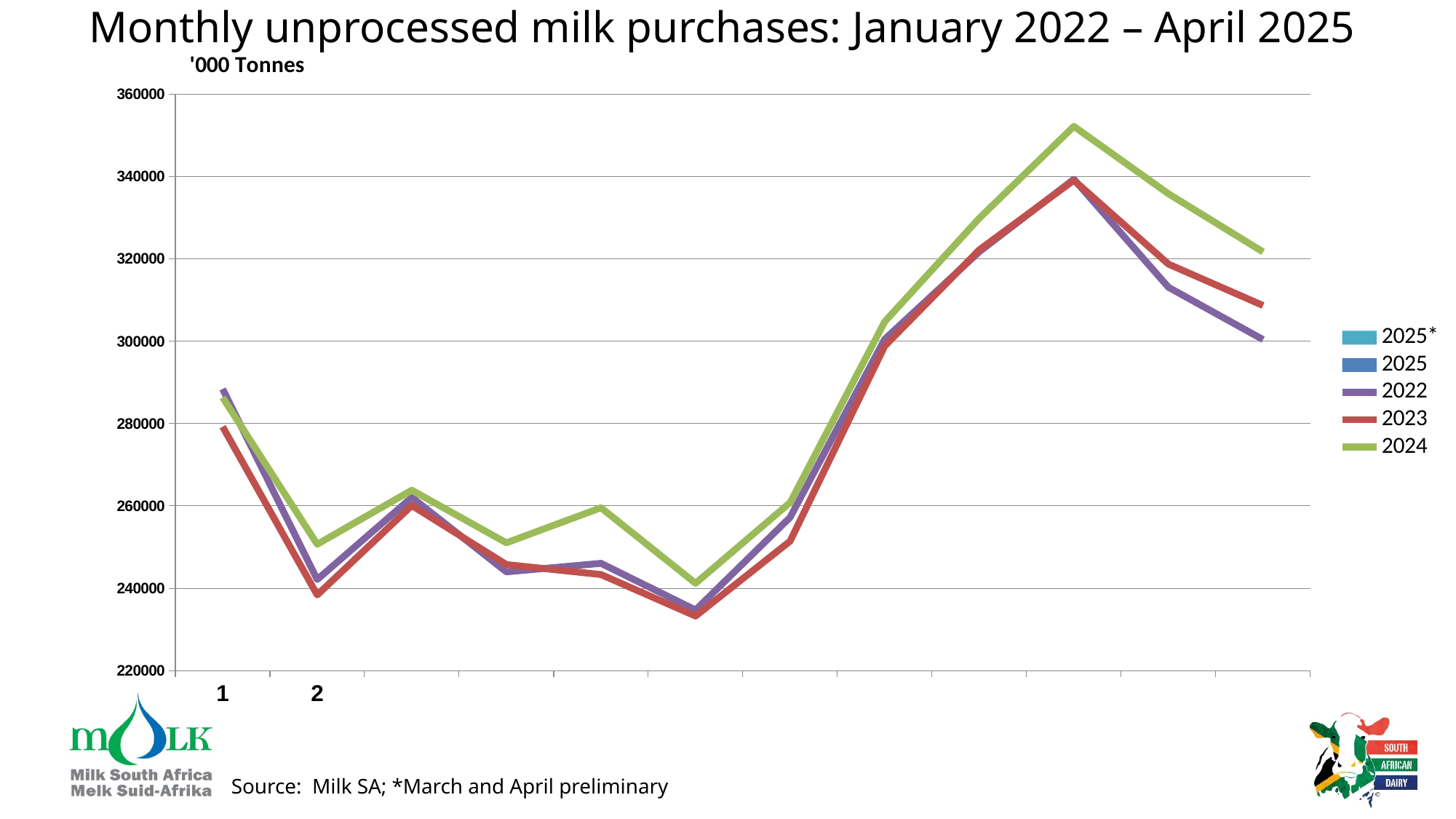
At month 1, which series has the lowest value? 2023 What kind of chart is shown on the slide? line chart Is the highest point of the 2024 line greater or less than 340000? greater How many series does the legend list? 5 At month 2, which series has the highest value? 2024 Is the value for 2024 at month 2 greater or less than 240000? greater From month 1 to month 2, do the values for 2023 rise or fall? fall At month 1, which is higher, the 2022 value or the 2023 value? 2022 What is the title of the chart? Monthly unprocessed milk purchases: January 2022 – April 2025 Is the value for 2023 at month 2 greater or less than 240000? less What unit is shown above the vertical axis? '000 Tonnes